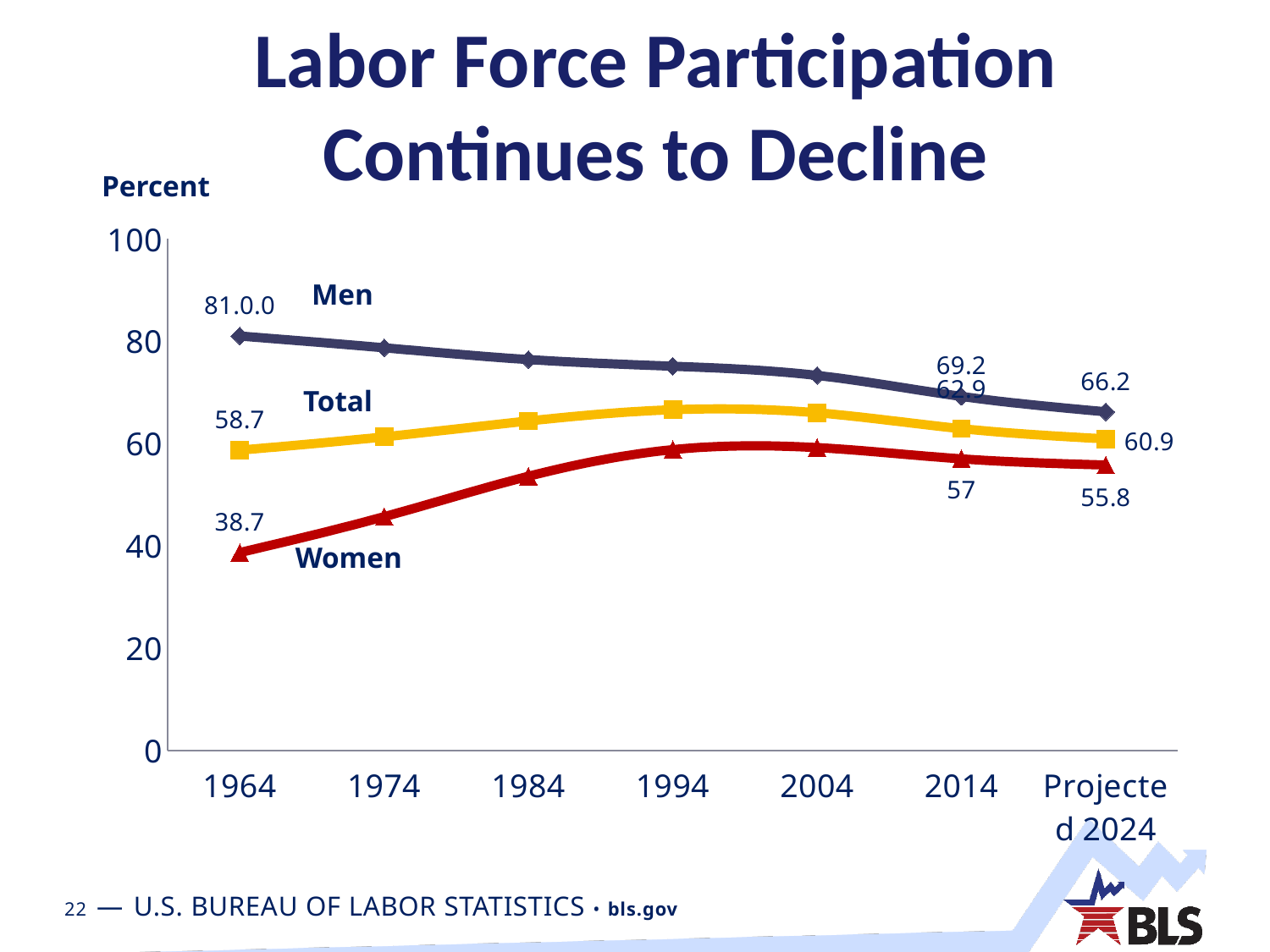
What kind of chart is shown? line chart What is the value for Men in 2014? 69.2 Which is larger in Projected 2024, the value for Men or the value for Women? Men Is the value for Men in 1984 greater or less than 80? less How many points are on the x axis? 7 What is the value for Women in 2014? 57 What is the difference between the Women value in 2014 and in Projected 2024? 1.2 What is the value for Total in Projected 2024? 60.9 Does the Men line rise or fall from 1964 to Projected 2024? fall What is the difference between the Men value in 2014 and in Projected 2024? 3 What is the value for Total in 1964? 58.7 What is the value for Women in 1964? 38.7